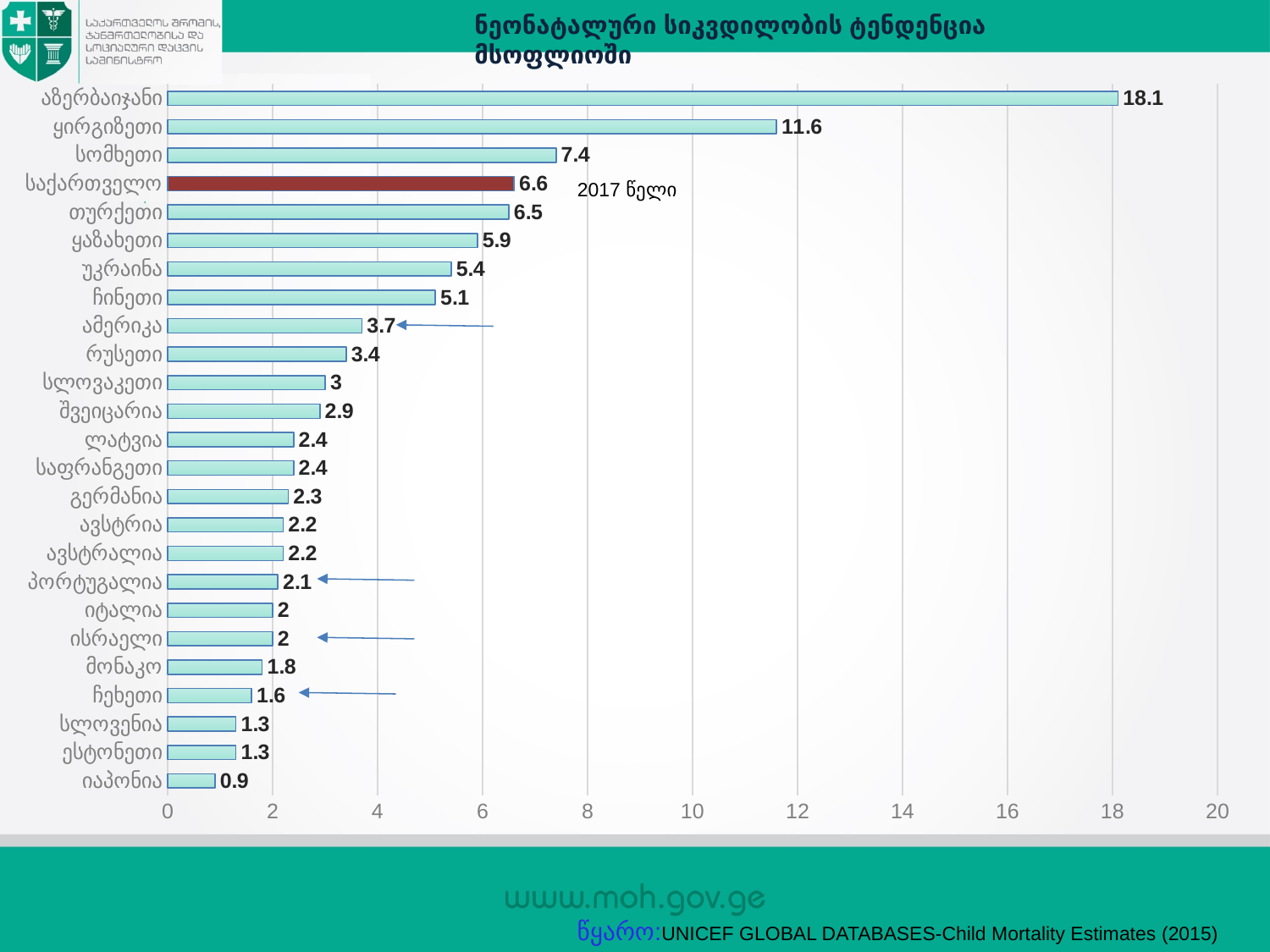
Is the value for ყირგიზეთი greater or less than 10? greater What kind of chart is shown on the slide? bar chart What is the value for ჩინეთი? 5.1 What is the value for იაპონია? 0.9 How many categories are shown in the chart? 25 Which bar is shown in a different colour (dark red) from the others? საქართველო What is the value for აზერბაიჯანი? 18.1 Which category has the highest value? აზერბაიჯანი Which is larger, the value for სომხეთი or the value for თურქეთი? სომხეთი Which category has the lowest value? იაპონია What is the value for საქართველო? 6.6 What is the difference between the values for აზერბაიჯანი and ყირგიზეთი? 6.5